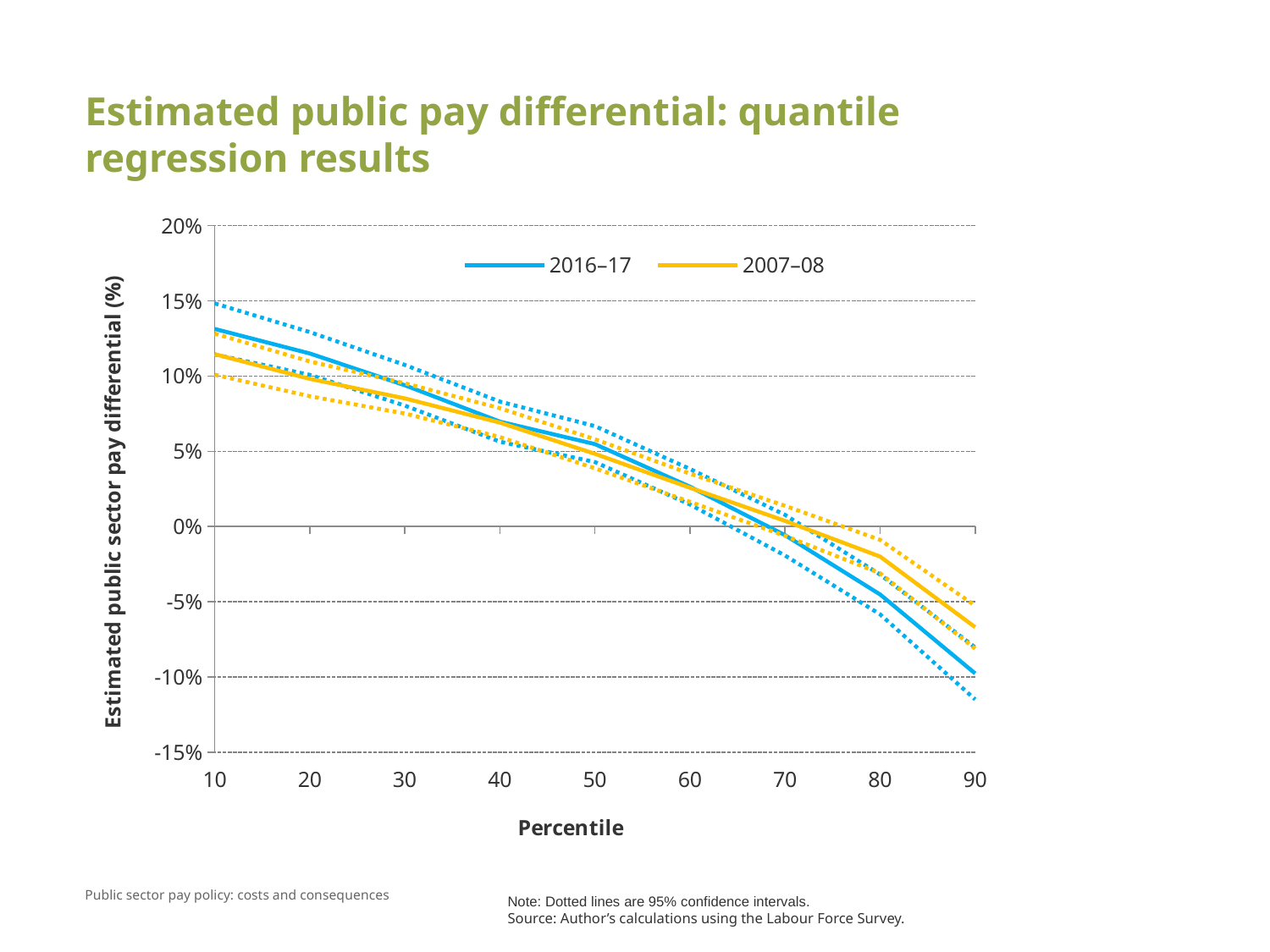
How many series does the legend list? 2 How many percentile points are marked along the x axis? 9 Is the 2016–17 value at the 80th percentile greater or less than 0%? less Do the estimated public pay differential values rise or fall as the percentile increases? Fall Is the 2016–17 value at the 10th percentile greater or less than 10%? greater Which two series are listed in the legend? 2016–17 and 2007–08 Is the 2007–08 value at the 80th percentile greater or less than -5%? greater What kind of chart is shown on the slide? Line chart What is the label of the x axis? Percentile At the 10th percentile, which series has the higher estimated pay differential, 2016–17 or 2007–08? 2016–17 At the 90th percentile, which series has the higher estimated pay differential, 2016–17 or 2007–08? 2007–08